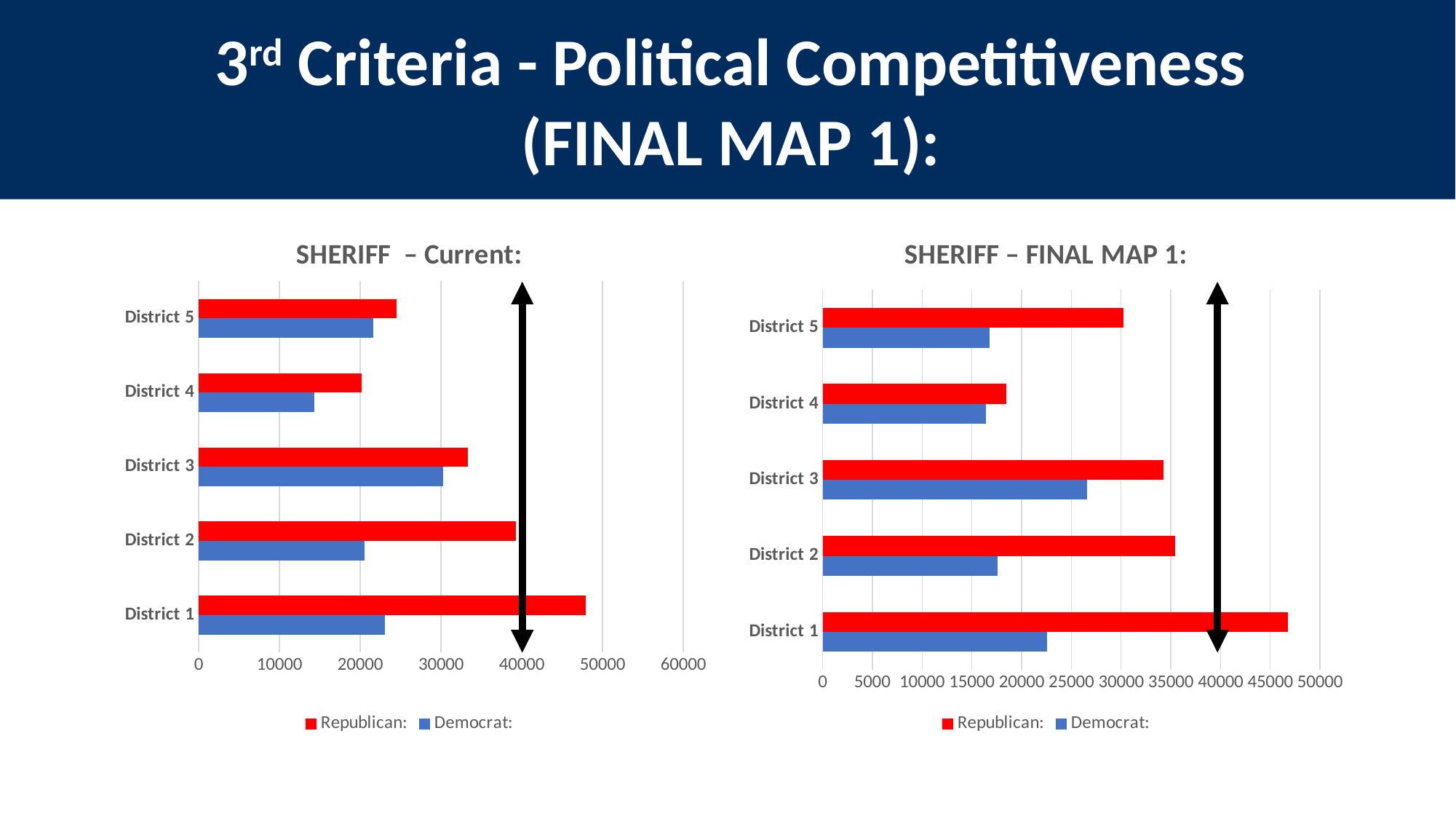
What kind of chart is the 'SHERIFF – Current:' chart? bar chart On the 'SHERIFF – FINAL MAP 1:' chart, is the Republican value for District 4 greater or less than 20000? less On the 'SHERIFF – FINAL MAP 1:' chart, which district has the lowest Republican value? District 4 On the 'SHERIFF – FINAL MAP 1:' chart, which district has the highest Republican value? District 1 On the 'SHERIFF – Current:' chart, which district has the highest Republican value? District 1 On the 'SHERIFF – Current:' chart, which district has the lowest Democrat value? District 4 On the 'SHERIFF – Current:' chart, is the Republican value for District 1 greater or less than 40000? greater On the 'SHERIFF – FINAL MAP 1:' chart, what colour represents the Democrat series? blue On the 'SHERIFF – Current:' chart, which is larger for District 2, the Republican value or the Democrat value? Republican How many series does the legend of the 'SHERIFF – Current:' chart list? 2 On the 'SHERIFF – FINAL MAP 1:' chart, is the Democrat value for District 3 greater or less than 25000? greater How many districts are shown on the 'SHERIFF – Current:' chart? 5